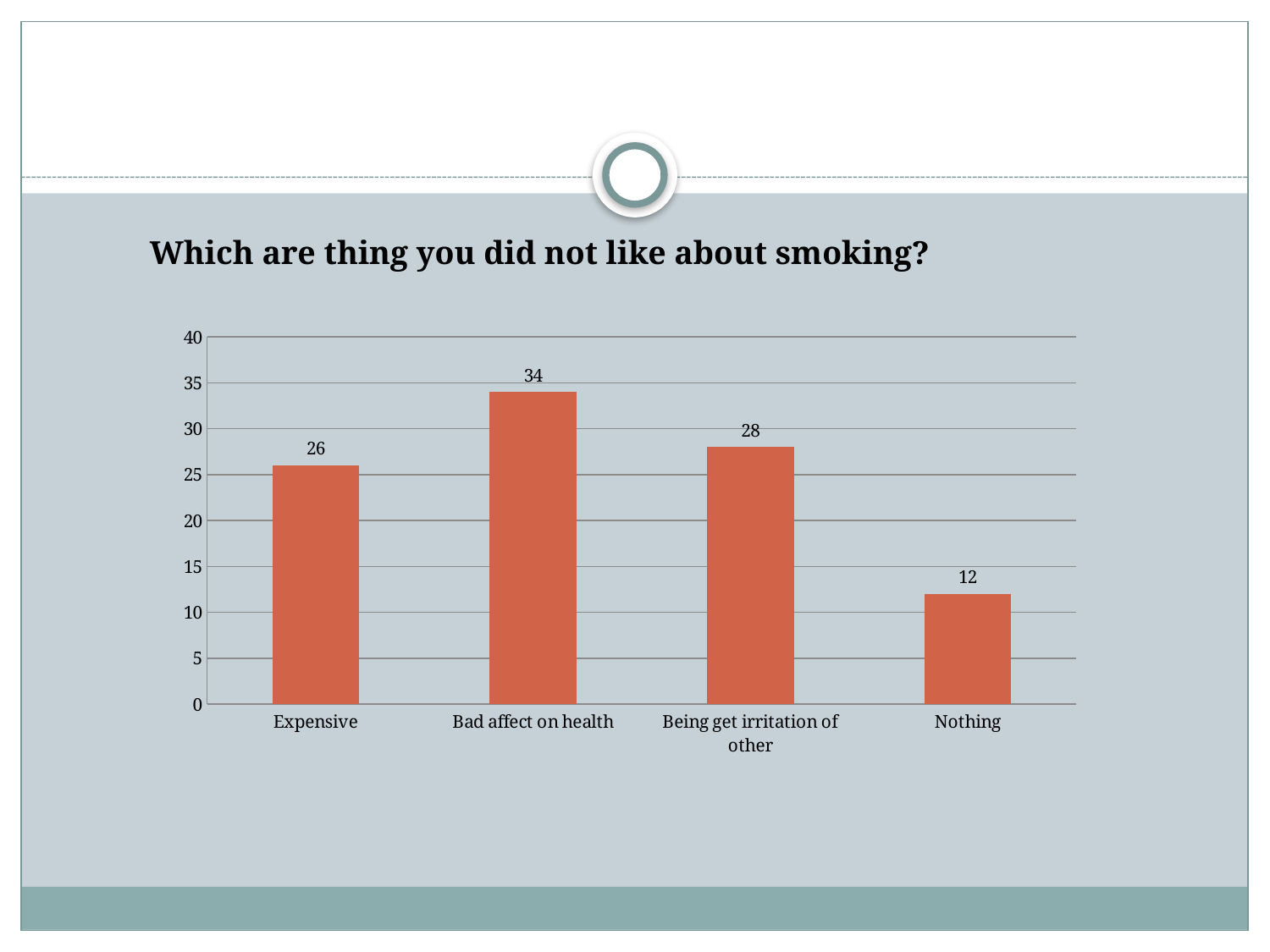
What is the difference between the values for Bad affect on health and Nothing? 22 What is the value for Being get irritation of other? 28 Which is larger, the value for Expensive or the value for Being get irritation of other? Being get irritation of other What is the difference between the values for Being get irritation of other and Expensive? 2 What kind of chart is shown on the slide? bar chart What is the value for Expensive? 26 Is the value for Nothing greater or less than 15? less Which category has the lowest value? Nothing What is the value for Bad affect on health? 34 How many categories are shown on the x axis? 4 What is the value for Nothing? 12 Which category has the highest value? Bad affect on health